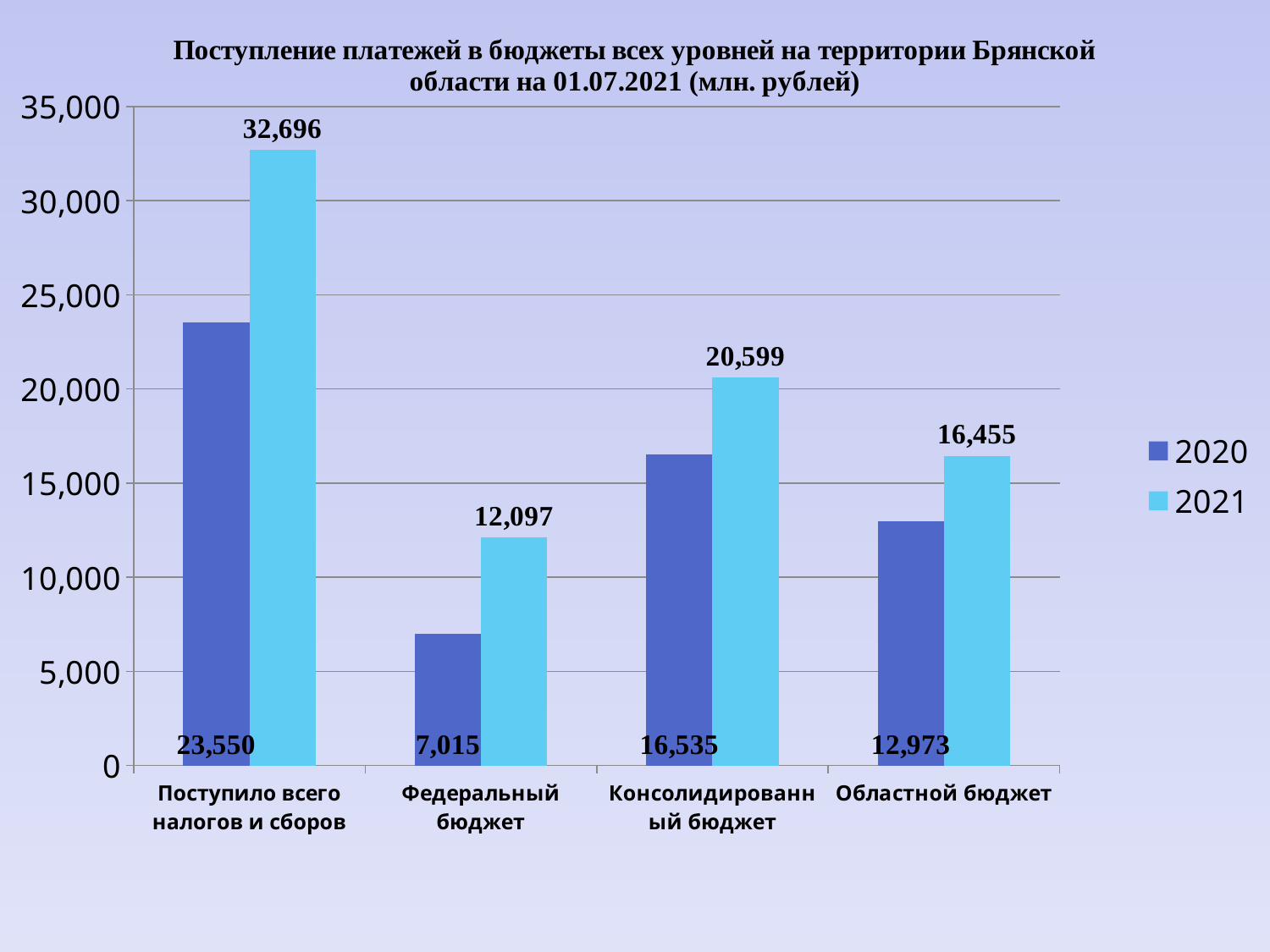
Which category has the highest 2021 value? Поступило всего налогов и сборов Which category has the lowest 2020 value? Федеральный бюджет What is the 2020 value for Федеральный бюджет? 7,015 How many categories are shown on the x axis? 4 What is the difference between the 2021 and 2020 values for Областной бюджет? 3,482 What is the 2021 value for Поступило всего налогов и сборов? 32,696 What kind of chart is shown on the slide? Bar chart Which is larger: the 2020 value for Консолидированный бюджет or the 2021 value for Областной бюджет? 2020 value for Консолидированный бюджет What is the 2021 value for Консолидированный бюджет? 20,599 How many series does the legend list? 2 What is the difference between the 2021 and 2020 values for Федеральный бюджет? 5,082 What is the 2020 value for Областной бюджет? 12,973